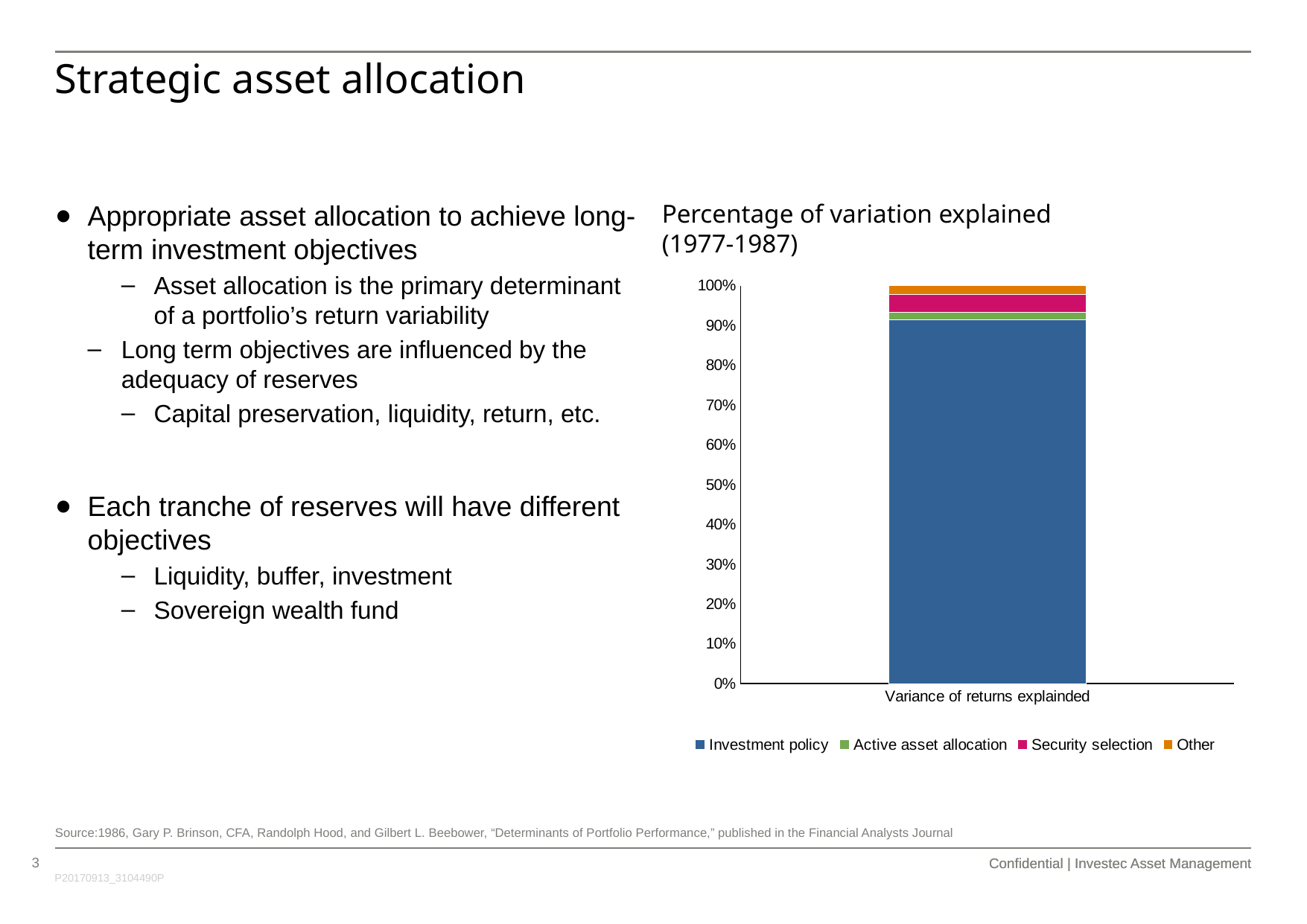
Is the value for Other greater or less than 10%? less Which is larger, the Security selection segment or the Active asset allocation segment? Security selection How many bars (categories) are plotted on the x axis? 1 What is the title of the chart? Percentage of variation explained (1977-1987) Is the value for Investment policy greater or less than 80%? greater Is the value for Security selection greater or less than 10%? less How many series does the chart legend list? 4 What kind of chart is shown on the slide? Stacked bar chart Which is larger, the Investment policy segment or the Security selection segment? Investment policy What is the category label on the x axis? Variance of returns explainded Which series accounts for the largest share of the stacked bar? Investment policy